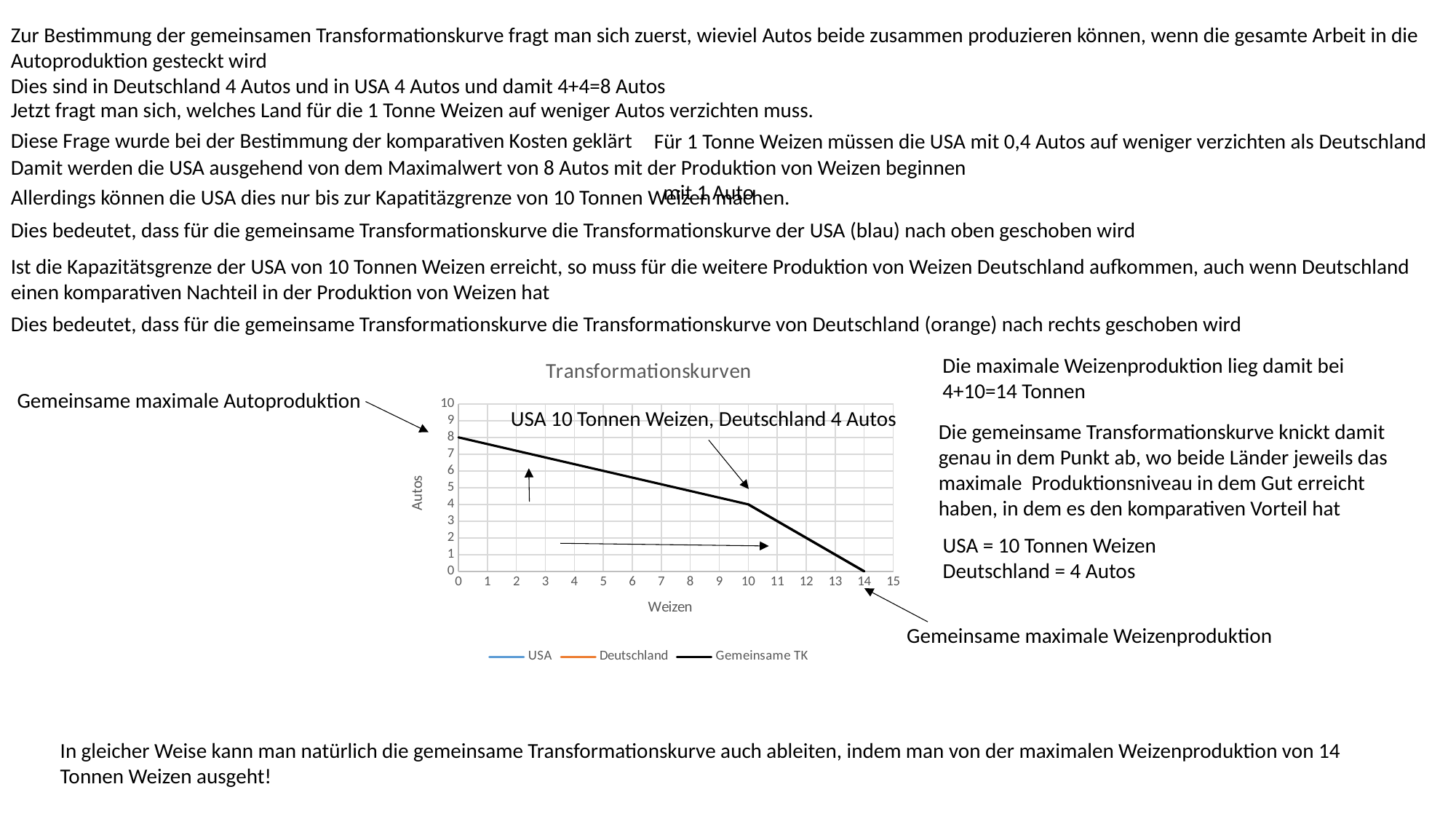
How many series does the legend of the "Transformationskurven" chart list? 3 In the "Transformationskurven" chart, is the Gemeinsame TK value at Weizen = 5 greater or less than 7 Autos? less In the "Transformationskurven" chart, at what Weizen value does the Gemeinsame TK line reach 0 Autos? 14 In the "Transformationskurven" chart, is the Gemeinsame TK value at Weizen = 12 greater or less than 4 Autos? less In the "Transformationskurven" chart, what is the difference in Autos between the Gemeinsame TK value at Weizen = 0 and at Weizen = 10? 4 In the "Transformationskurven" chart, how many Autos does the Gemeinsame TK line show at Weizen = 10? 4 In the "Transformationskurven" chart, which is larger: the Gemeinsame TK value at Weizen = 0 or at Weizen = 10? Weizen = 0 Does the Gemeinsame TK line in the "Transformationskurven" chart rise or fall as Weizen increases? fall What are the axis titles of the "Transformationskurven" chart? Weizen (x axis) and Autos (y axis) What is the title of the chart on the slide? Transformationskurven In the "Transformationskurven" chart, how many Autos does the Gemeinsame TK line show at Weizen = 0? 8 What kind of chart is shown under the title "Transformationskurven"? line chart